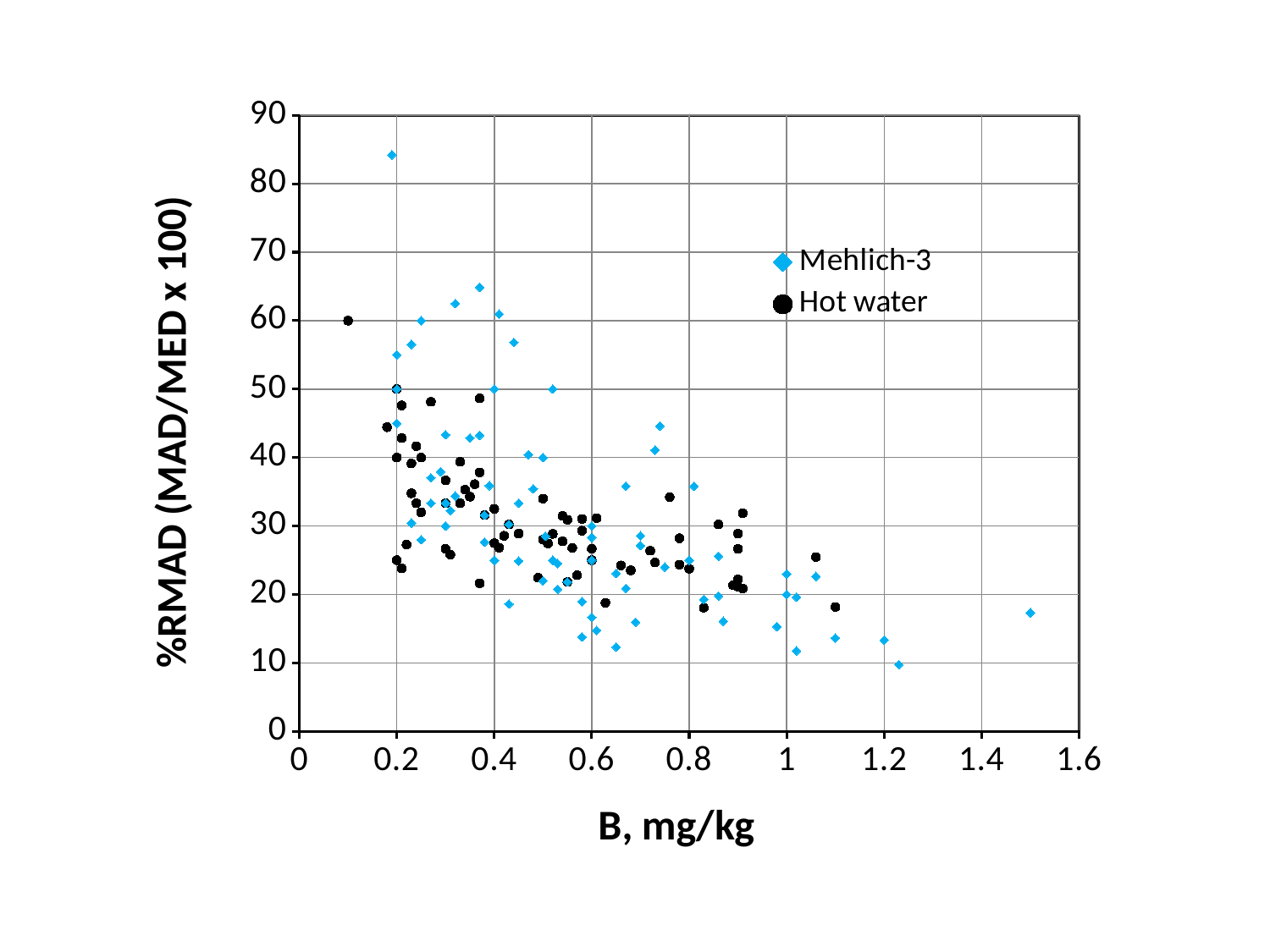
Which series contains the single highest %RMAD point on the chart? Mehlich-3 What kind of chart is shown on the slide? scatter chart Do the %RMAD values generally rise or fall as B (mg/kg) increases along the x axis? fall What is the maximum value shown on the y axis? 90 Which series has the point that extends furthest to the right along the x axis? Mehlich-3 Is the highest Mehlich-3 point (near B = 0.2 mg/kg) greater or less than 80 %RMAD? greater What is the label of the x axis? B, mg/kg Is the Mehlich-3 point at about B = 1.5 mg/kg greater or less than 20 %RMAD? less Is the Hot water point at about B = 0.1 mg/kg greater or less than 50 %RMAD? greater How many series does the legend list? 2 What are the two series named in the legend? Mehlich-3 and Hot water